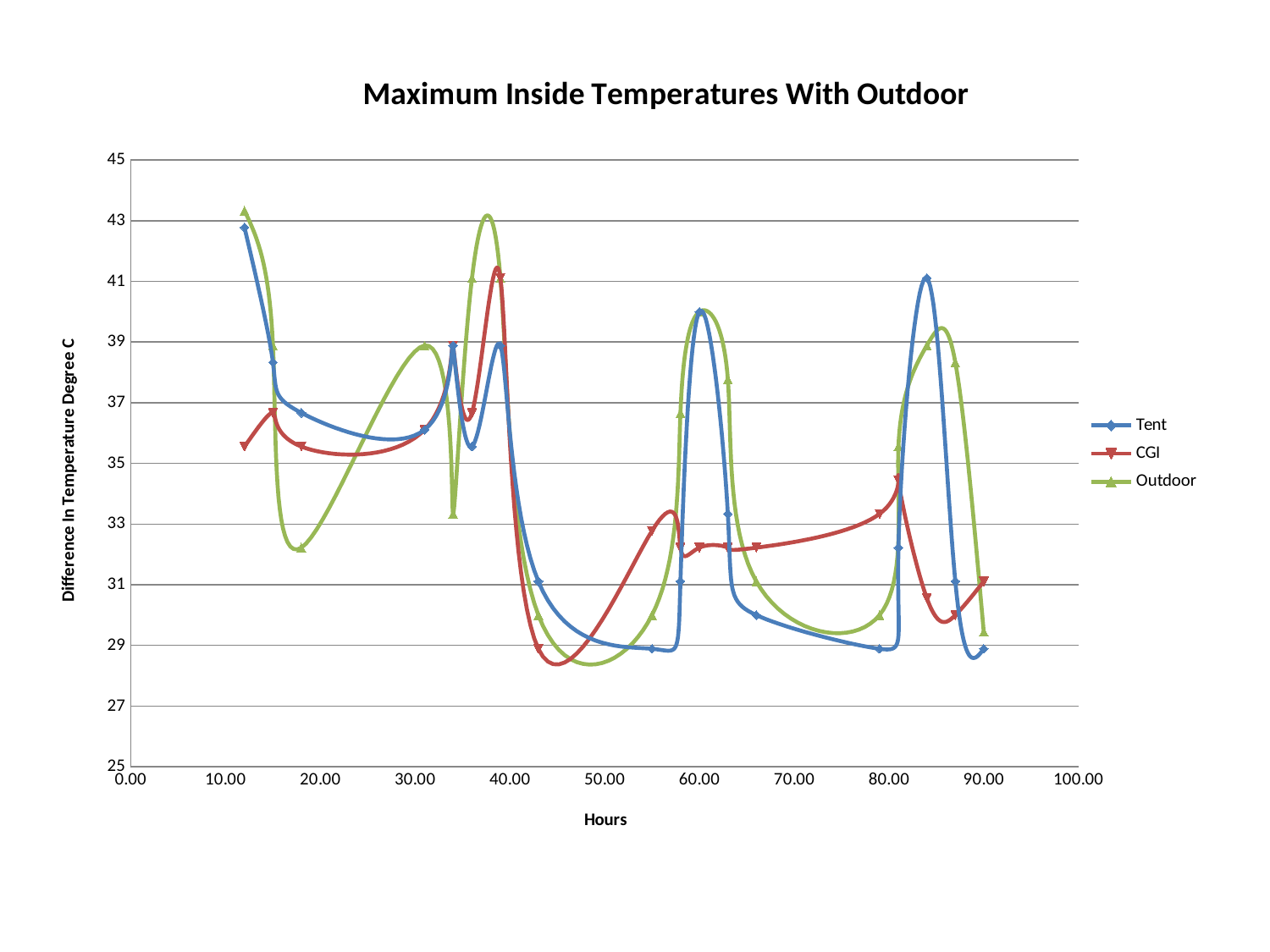
Does the Outdoor series rise or fall between about 18 and 31 hours? rise What is the title of the chart? Maximum Inside Temperatures With Outdoor Is the CGI value at about 45 hours greater or less than 31? less Is the Tent value at about 84 hours greater or less than 39? greater At about 66 hours, which series has the higher value, CGI or Tent? CGI At about 84 hours, which series has the higher value, Tent or CGI? Tent What kind of chart is shown on the slide? line chart At about 18 hours, which series has the higher value, Tent or Outdoor? Tent How many series does the legend list? 3 What is the label of the x axis? Hours Is the Outdoor value at about 18 hours greater or less than 35? less